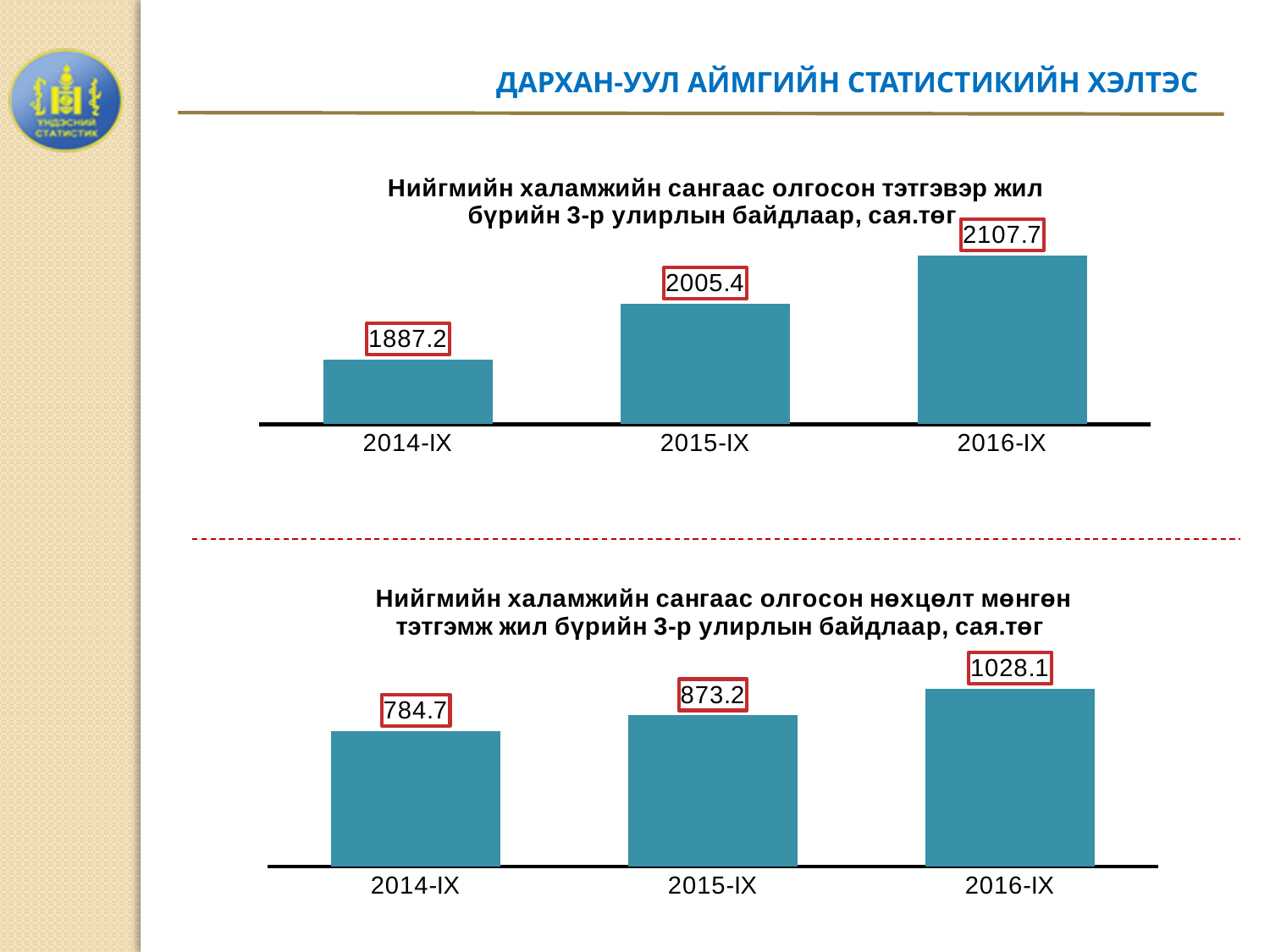
In the bottom chart, which year has the lowest value? 2014-IX In the bottom chart, which is larger, the value for 2014-IX or 2015-IX? 2015-IX In the top chart, what is the value for 2016-IX? 2107.7 In the top chart, do the values rise or fall from 2014-IX to 2016-IX? rise In the top chart, what is the value for 2014-IX? 1887.2 What type of chart is the bottom chart? bar chart In the bottom chart, what is the difference between the values for 2016-IX and 2014-IX? 243.4 In the bottom chart, what is the value for 2015-IX? 873.2 In the top chart, what is the difference between the values for 2016-IX and 2015-IX? 102.3 How many bars are in the top chart? 3 In the top chart, which year has the highest value? 2016-IX In the bottom chart, what is the value for 2016-IX? 1028.1